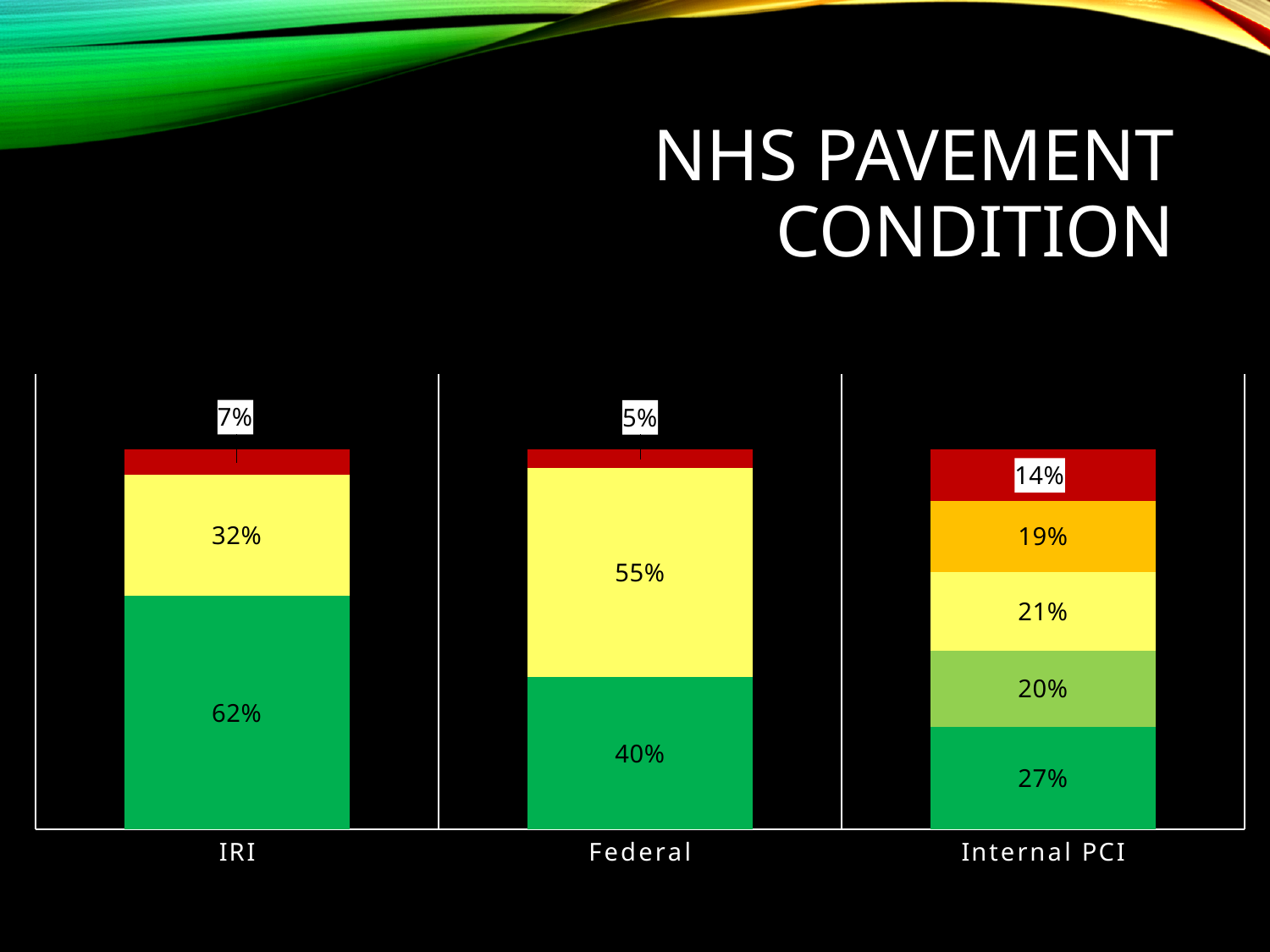
Which bar has the larger yellow segment, IRI or Federal? Federal How many segments make up the Internal PCI bar? 5 What percentage does the yellow segment of the Federal bar show? 55% What percentage does the orange segment of the Internal PCI bar show? 19% What percentage does the red segment of the Federal bar show? 5% What percentage does the red segment at the top of the Internal PCI bar show? 14% What is the total of the segments in the Federal bar? 100% How many bars (categories) are shown along the x axis? 3 What percentage does the green segment of the IRI bar show? 62% What type of chart is shown on the slide? Stacked bar chart What is the difference between the green segment of the IRI bar and the green segment of the Federal bar? 22% Which bar has the largest green segment? IRI